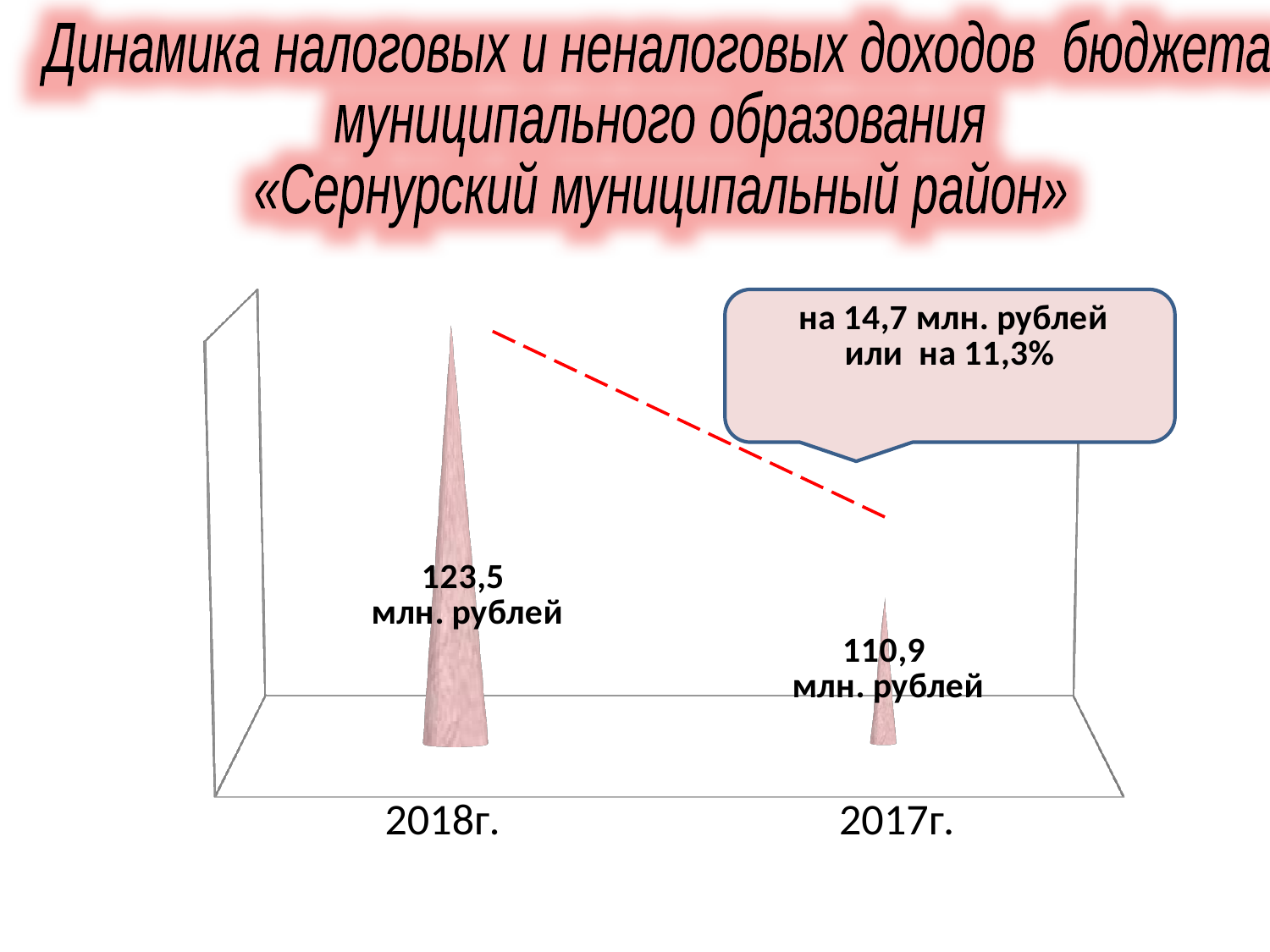
What is the value for 2018г.? 123,5 млн. рублей How many categories are shown on the chart? 2 Which year has the highest value? 2018г. What kind of chart is shown on the slide? bar chart What change in млн. рублей is stated in the callout on the chart? 14,7 млн. рублей What is the value for 2017г.? 110,9 млн. рублей Which is larger, the value for 2018г. or the value for 2017г.? 2018г. Which year has the lowest value? 2017г. What percentage change is stated in the callout on the chart? 11,3%